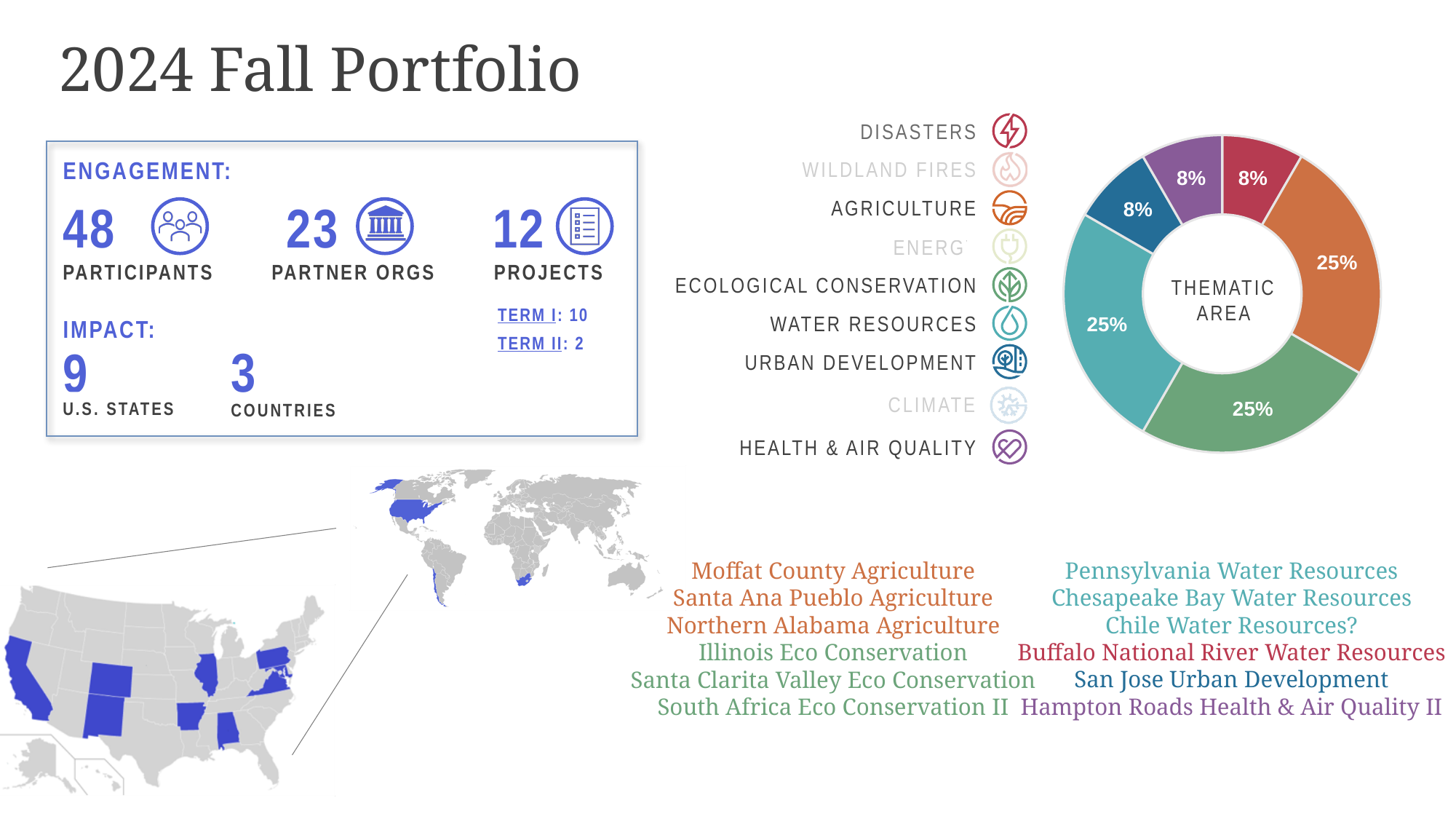
How many slices in the Thematic Area chart are labeled 25%? 3 What share of the Thematic Area chart does Urban Development (dark blue) represent? 8% What share of the Thematic Area chart does Disasters (red) represent? 8% What share of the Thematic Area chart does Water Resources (teal) represent? 25% What is the difference between the Water Resources share and the Urban Development share in the Thematic Area chart? 17% What kind of chart is the Thematic Area chart? Donut (pie) chart In the Thematic Area chart, which is larger: the Agriculture slice or the Disasters slice? Agriculture What is the title shown in the center of the donut chart? Thematic Area How many slices does the Thematic Area donut chart have? 6